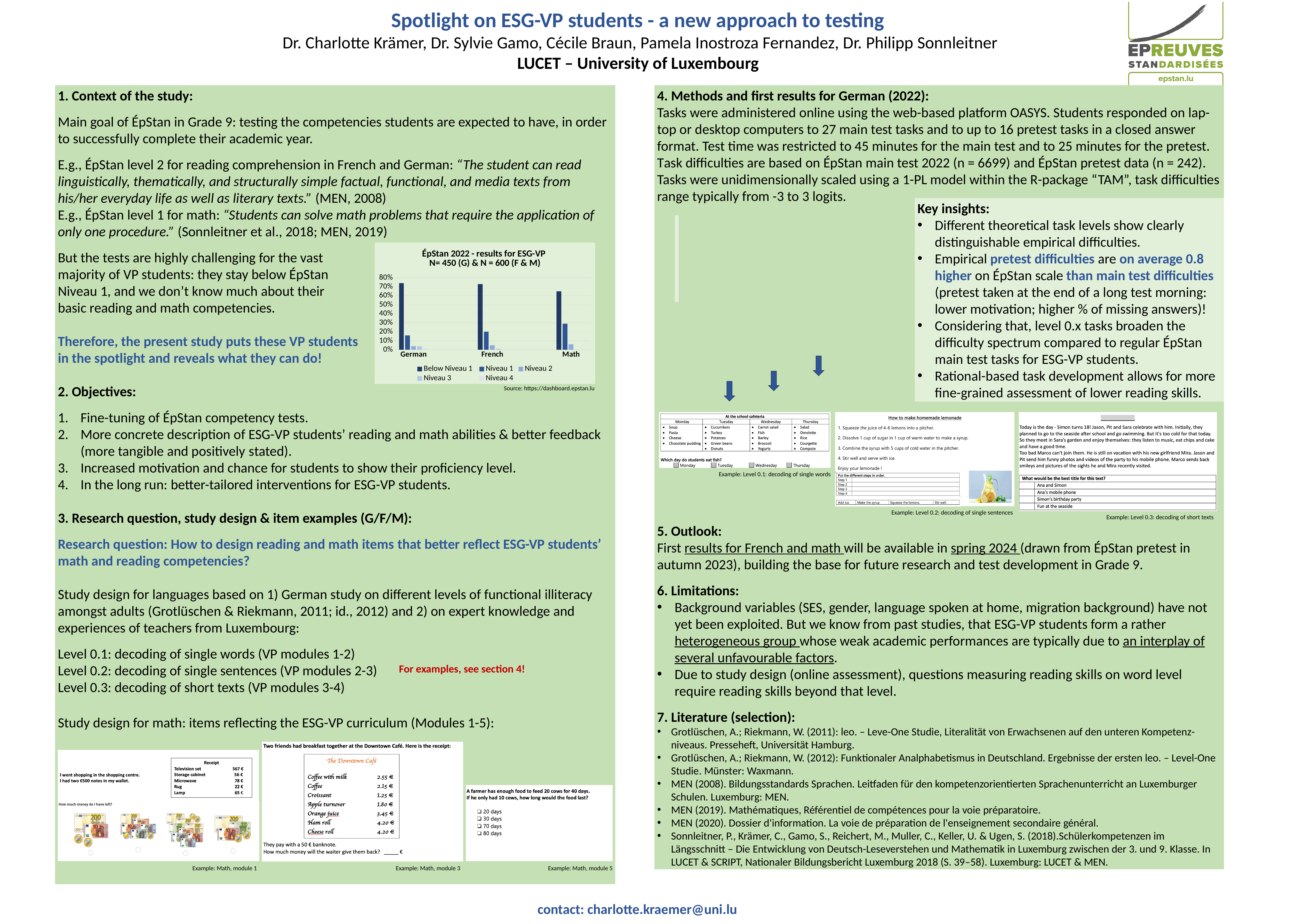
What kind of chart is the 'ÉpStan 2022 - results for ESG-VP' chart? bar chart In the 'ÉpStan 2022 - results for ESG-VP' chart, is the 'Niveau 1' share larger for Math or for German? Math In the 'ÉpStan 2022 - results for ESG-VP' chart, which subject has the lowest 'Below Niveau 1' share? Math What source is cited below the 'ÉpStan 2022 - results for ESG-VP' chart? https://dashboard.epstan.lu In the 'ÉpStan 2022 - results for ESG-VP' chart, is the 'Niveau 1' value for Math greater or less than 40%? less In the 'ÉpStan 2022 - results for ESG-VP' chart, is the 'Below Niveau 1' value for German greater or less than 60%? greater In the 'ÉpStan 2022 - results for ESG-VP' chart, is the 'Below Niveau 1' value for Math greater or less than 50%? greater In the 'ÉpStan 2022 - results for ESG-VP' chart, which level has the highest share for German? Below Niveau 1 How many subject categories are shown on the x axis of the 'ÉpStan 2022 - results for ESG-VP' chart? 3 In the 'ÉpStan 2022 - results for ESG-VP' chart, is the 'Below Niveau 1' share larger for German or for Math? German How many series does the legend of the 'ÉpStan 2022 - results for ESG-VP' chart list? 5